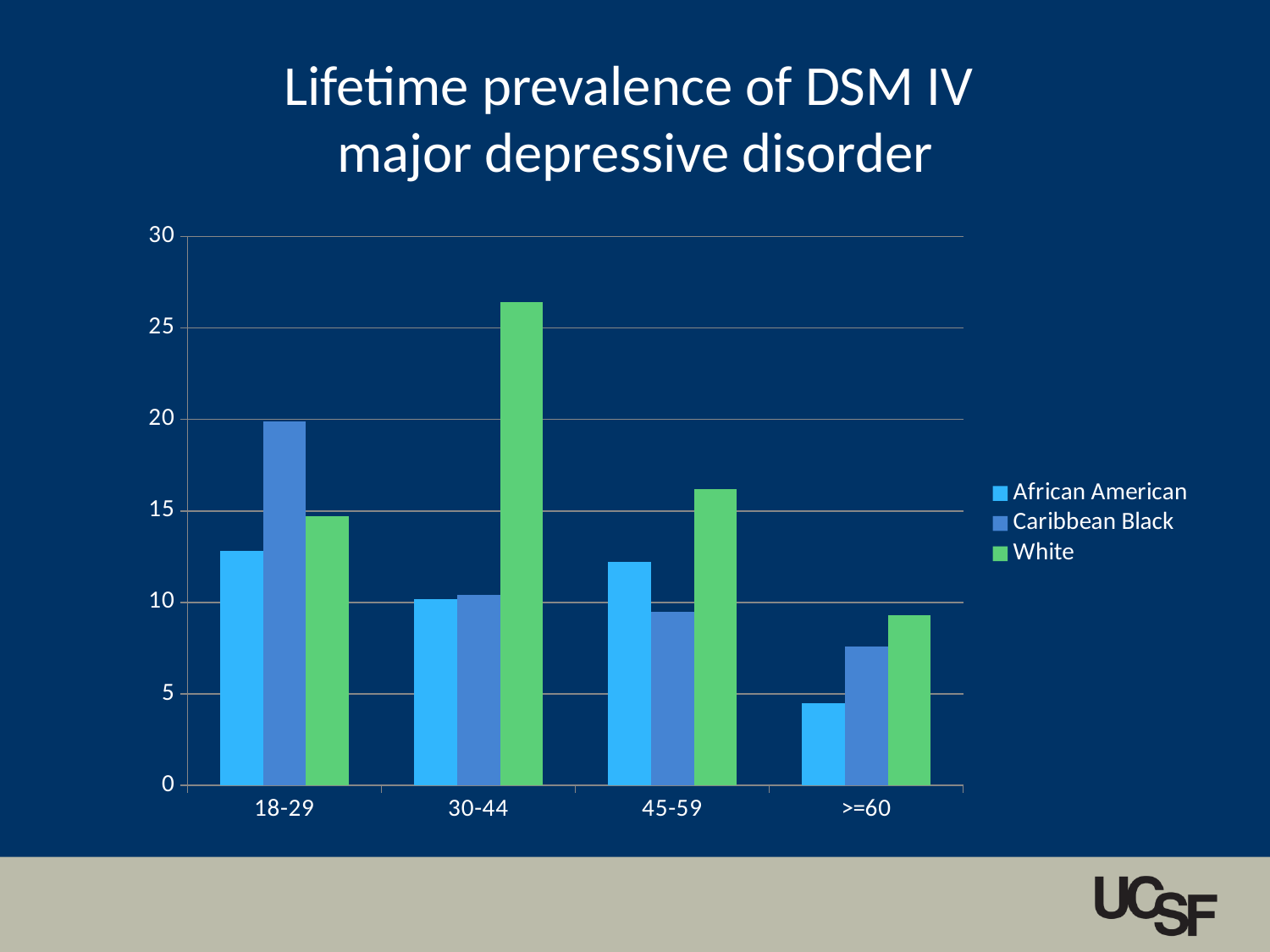
How many age groups are shown on the x axis? 4 In the 18-29 age group, which is larger: Caribbean Black or White? Caribbean Black Is the value for White in the 30-44 age group greater or less than 25? greater Which series has the lowest value in the >=60 age group? African American Is the value for Caribbean Black in the 18-29 age group greater or less than 15? greater How many series does the legend list? 3 In the 45-59 age group, which is larger: African American or Caribbean Black? African American Is the value for White in the 45-59 age group greater or less than 15? greater What kind of chart is shown on the slide? bar chart Which age group has the highest value for the White series? 30-44 What is the title of the chart? Lifetime prevalence of DSM IV major depressive disorder